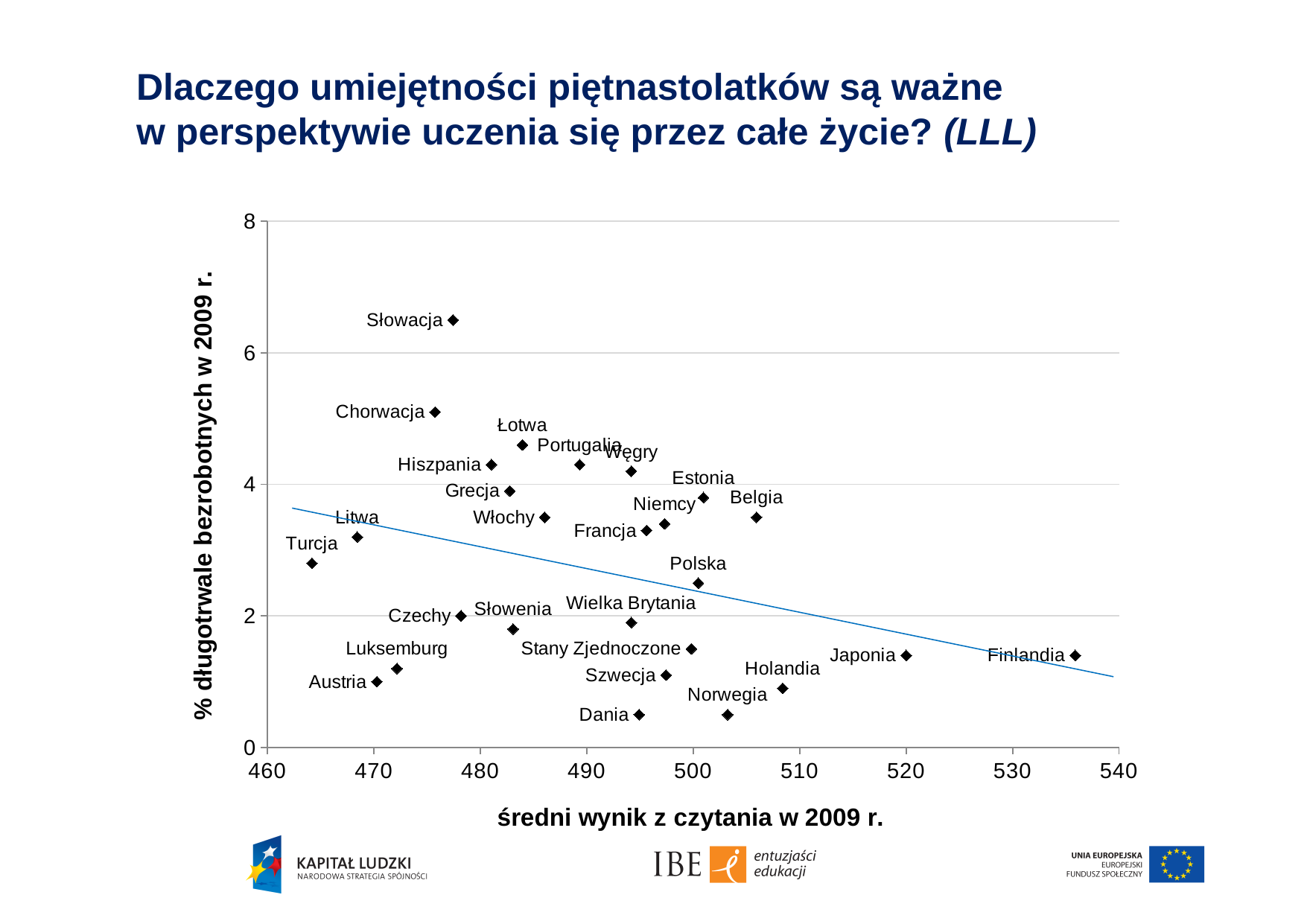
Is the long-term unemployment value for Słowacja greater or less than 6? greater Which has a higher long-term unemployment rate, Słowacja or Chorwacja? Słowacja Which country has the highest long-term unemployment rate (% długotrwale bezrobotnych) on the chart? Słowacja Which has a higher average reading score, Japonia or Polska? Japonia Is the average reading score for Finlandia greater or less than 530? greater What kind of chart is shown on the slide? scatter plot Is the long-term unemployment value for Austria greater or less than 2? less Does the trend line rise or fall as the average reading score increases? falls Which country has the lowest average reading score on the chart? Turcja What is the label of the horizontal axis? średni wynik z czytania w 2009 r. Which country has the highest average reading score (średni wynik z czytania) on the chart? Finlandia